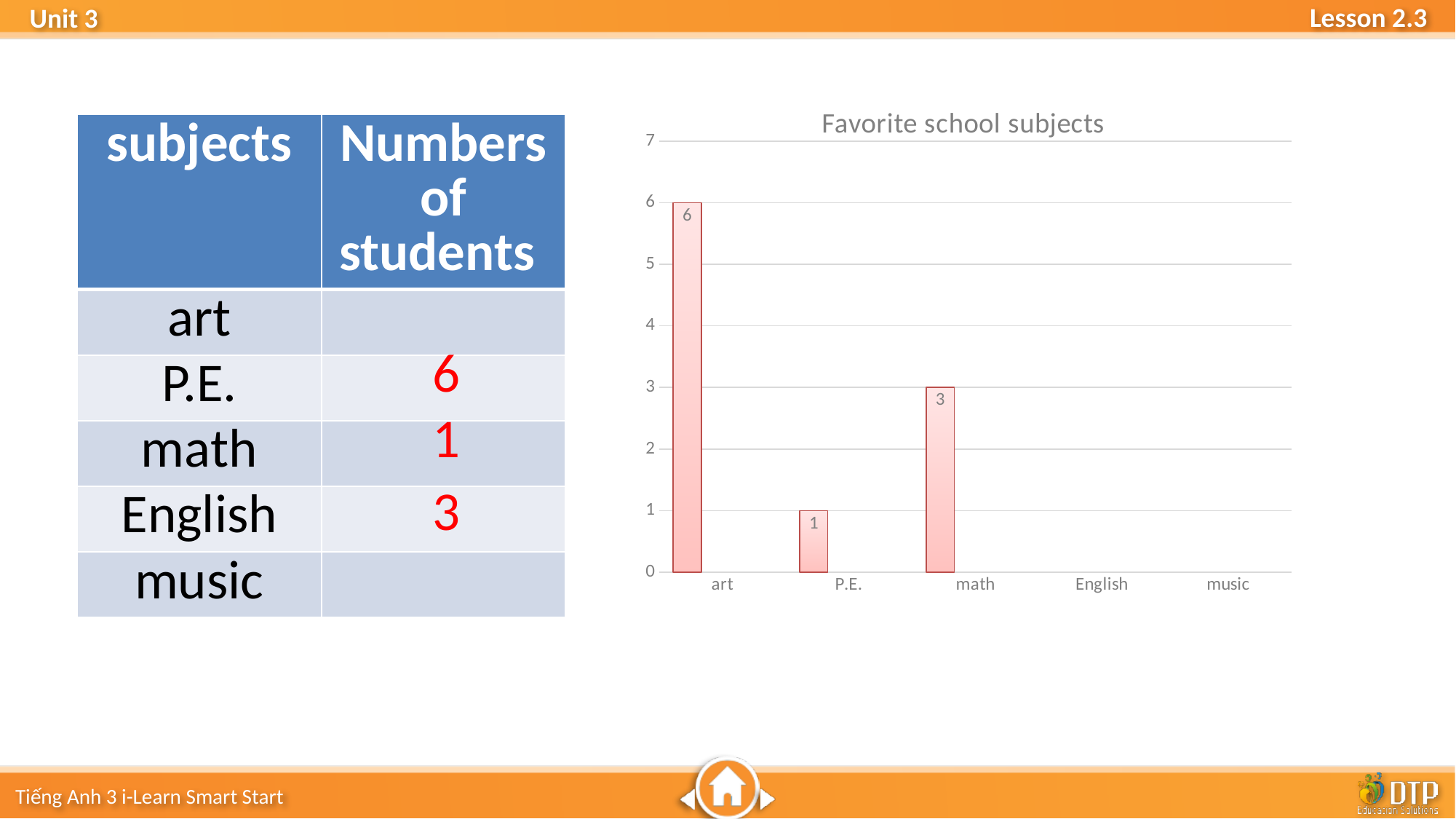
Among the subjects with a bar shown, which has the lowest value? P.E. What is the difference between the values for math and P.E. in the chart? 2 How many subject categories are labeled on the x axis of the chart? 5 Which has a larger value in the chart, P.E. or math? math What is the difference between the values for art and math in the chart? 3 What is the value of the bar for math in the chart? 3 What is the title of the chart? Favorite school subjects Is the value for art in the chart greater or less than 5? greater Which subject has the tallest bar in the chart? art What type of chart is shown on the slide? bar chart What is the value of the bar for art in the chart? 6 What is the value of the bar for P.E. in the chart? 1